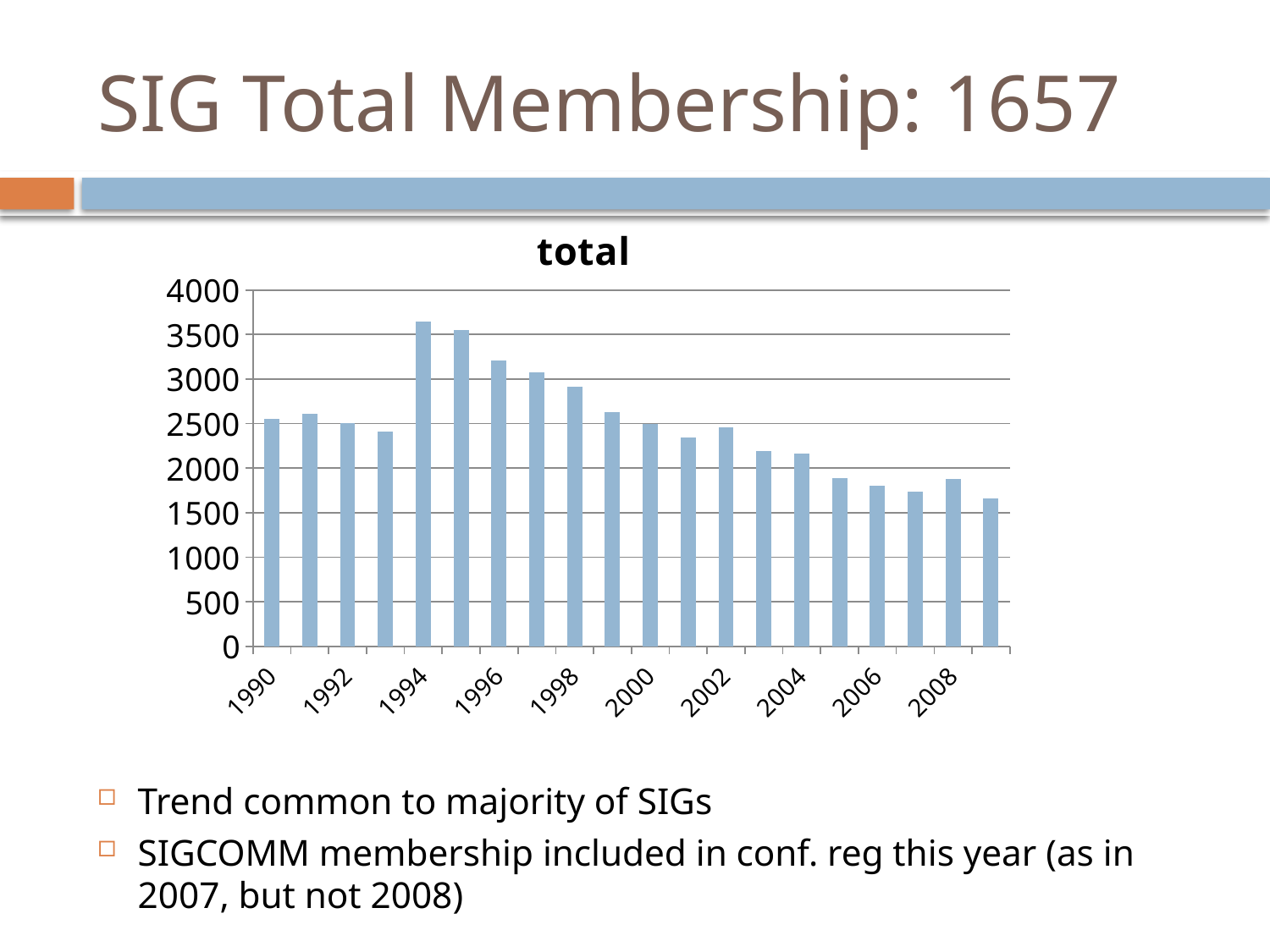
How many bars are plotted in the chart? 20 Which is larger, the value for 1996 or the value for 2000? 1996 Is the value for 1994 greater or less than 3500? greater What kind of chart is shown on the slide? bar chart Is the value for 1996 greater or less than 3000? greater Is the value for 2004 greater or less than 2000? greater What is the title of the chart? total Do the values generally rise or fall from 1994 to 2008? fall Which is larger, the value for 1994 or the value for 2008? 1994 Which year has the highest bar in the chart? 1994